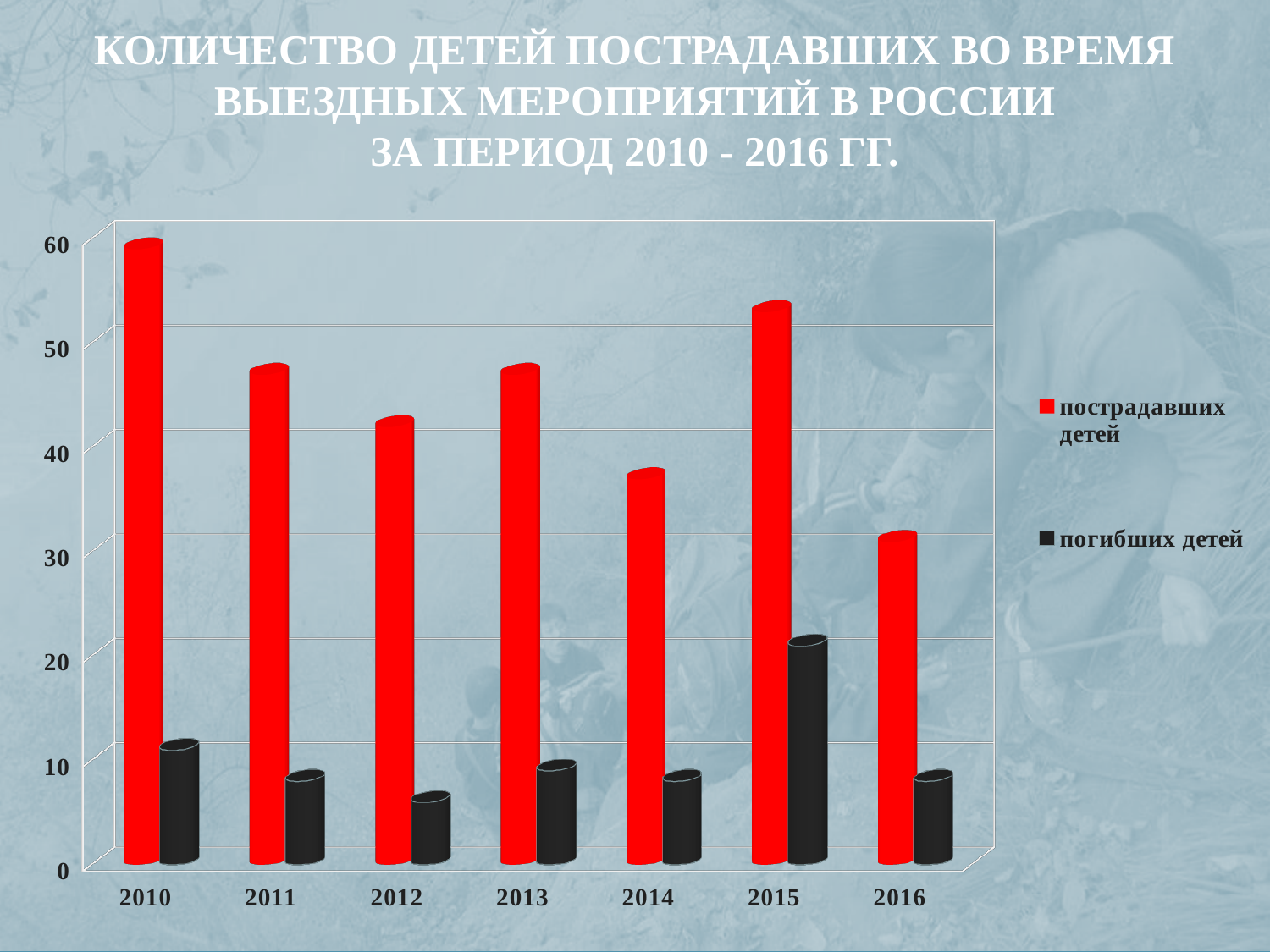
In which year is the value for погибших детей the highest? 2015 How many years are shown on the x axis? 7 Is the value for пострадавших детей in 2016 greater or less than 40? less In which year is the value for пострадавших детей the highest? 2010 In which year is the value for пострадавших детей the lowest? 2016 Is the value for пострадавших детей in 2010 greater or less than 50? greater Is the value for погибших детей in 2015 greater or less than 10? greater How many series does the legend list? 2 Which is larger: the value for пострадавших детей in 2015 or in 2014? 2015 What kind of chart is shown on the slide? bar chart In which year is the value for погибших детей the lowest? 2012 Which series is shown in red in the legend? пострадавших детей